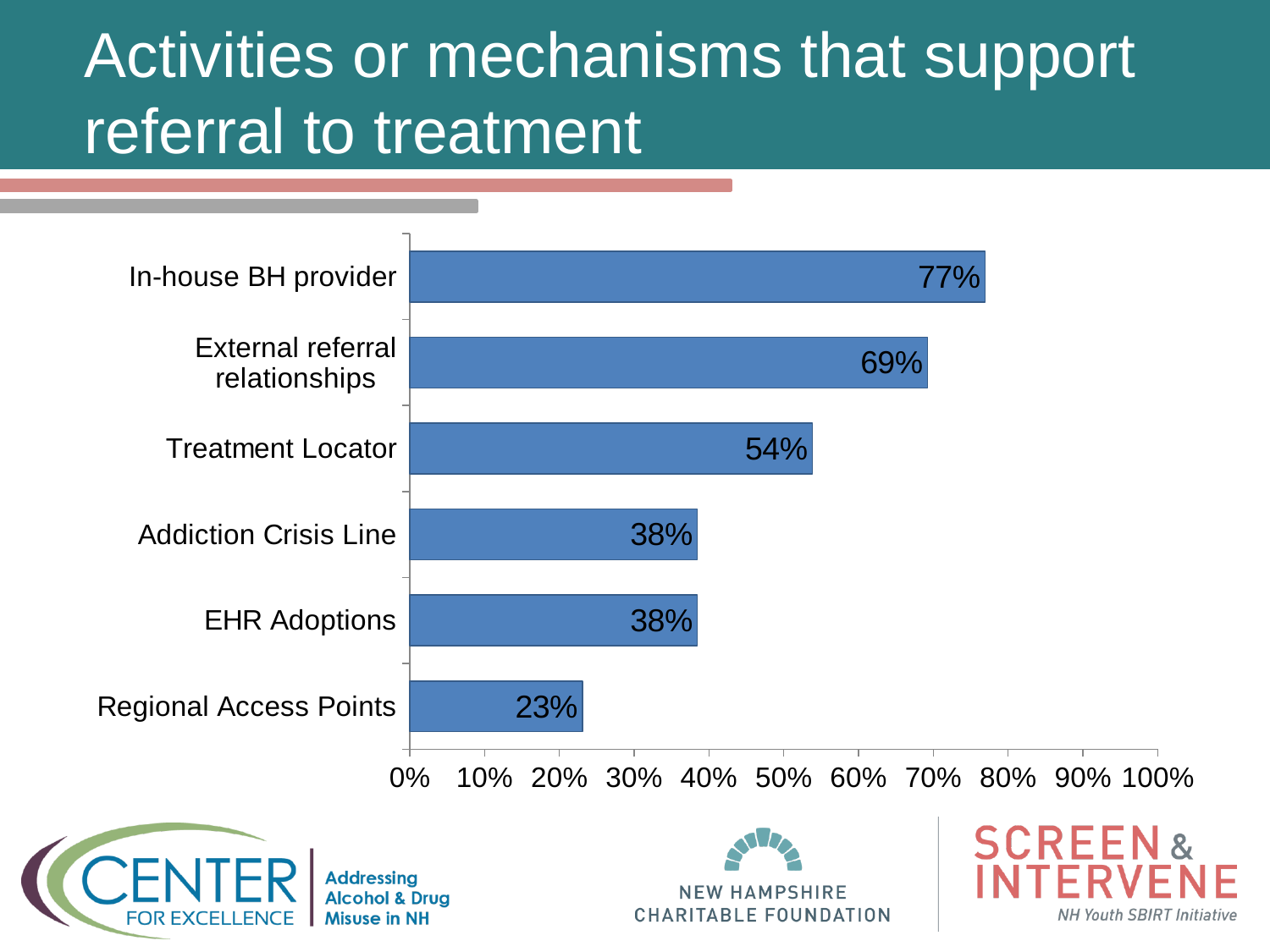
What is the difference between the values for Treatment Locator and Regional Access Points? 31% What is the difference between the values for In-house BH provider and External referral relationships? 8% What is the value for In-house BH provider? 77% Is the value for EHR Adoptions greater or less than 40%? less How many categories are shown in the chart? 6 Which is larger, the value for Treatment Locator or the value for Addiction Crisis Line? Treatment Locator Which category has the lowest value? Regional Access Points What is the value for External referral relationships? 69% What is the value for Regional Access Points? 23% What is the value for Treatment Locator? 54% What kind of chart is shown on the slide? bar chart Which category has the highest value? In-house BH provider